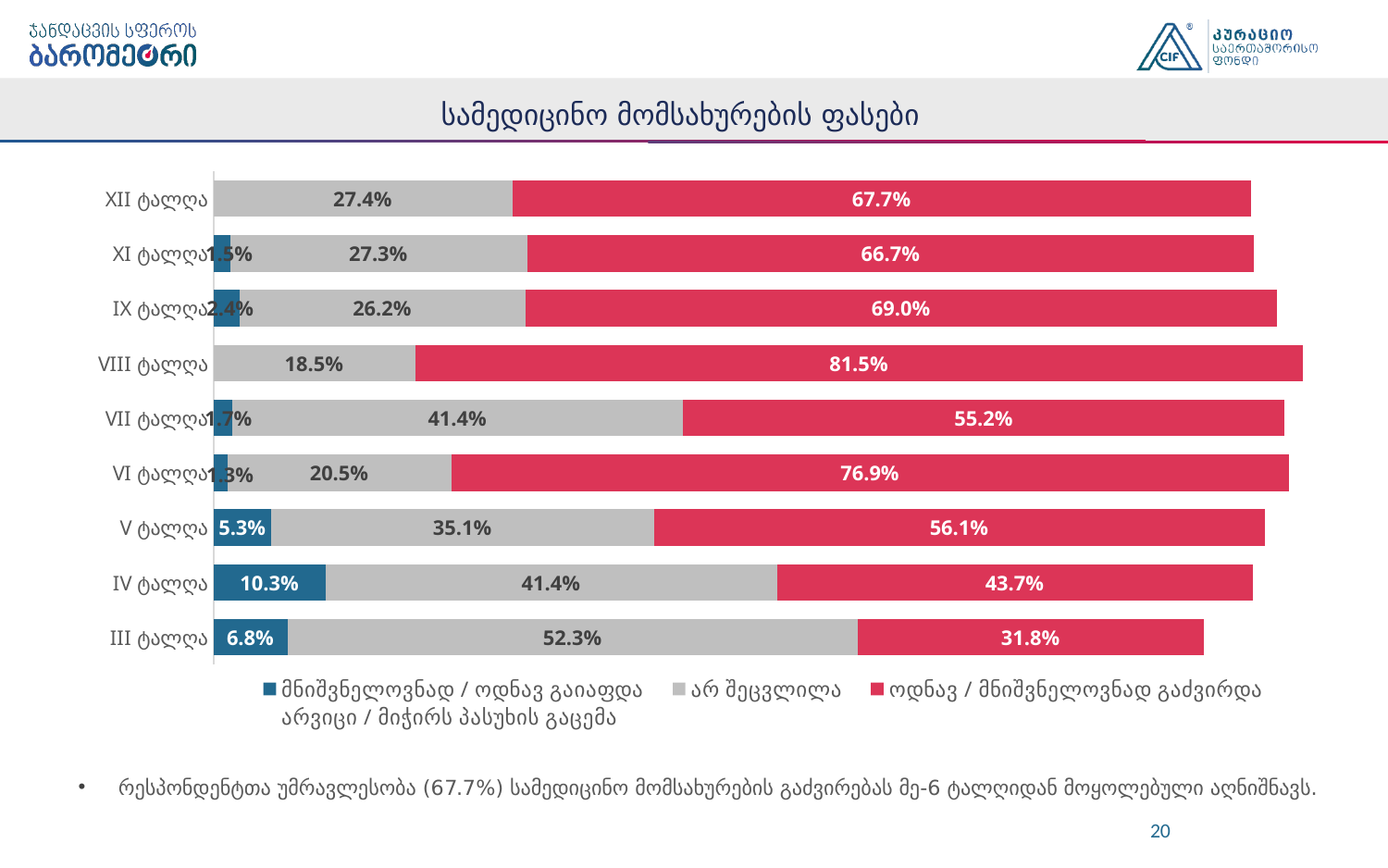
For V ტალღა, which is larger: the red value or the grey value? The red value (56.1%) Which category has the lowest value for the red series (ოდნავ / მნიშვნელოვნად გაძვირდა)? III ტალღა What is the value of the red series (ოდნავ / მნიშვნელოვნად გაძვირდა) for VIII ტალღა? 81.5% What kind of chart is shown on the slide? Stacked bar chart How many categories (waves) are shown in the chart? 9 What is the value of the grey series (არ შეცვლილა) for III ტალღა? 52.3% What is the total of the stacked bar for V ტალღა? 96.5% How many series does the legend list? 4 What is the value of the blue series for IV ტალღა? 10.3% Which category has the highest value for the red series (ოდნავ / მნიშვნელოვნად გაძვირდა)? VIII ტალღა Which category has the lowest value for the grey series (არ შეცვლილა)? VIII ტალღა What is the difference between the red value and the blue value for IV ტალღა? 33.4 percentage points